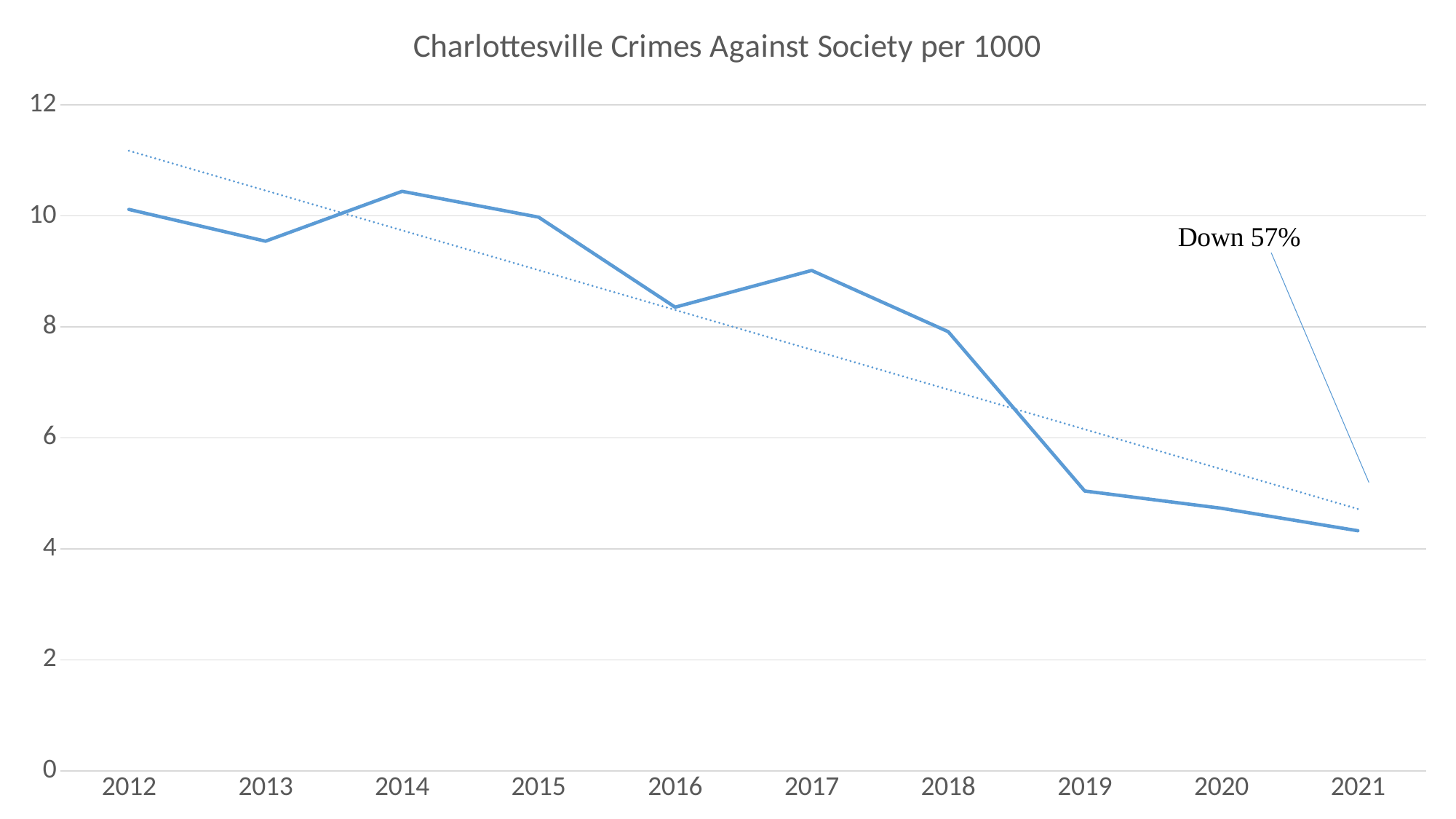
How many years are plotted along the x axis? 10 Is the value for 2019 greater or less than 6? less What does the annotation on the chart say about the change? Down 57% Is the value for 2021 greater or less than 4? greater Is the value for 2013 greater or less than 10? less Which is larger, the value for 2018 or the value for 2019? 2018 Which year has the lowest value? 2021 Overall, do the values rise or fall from 2012 to 2021? fall What is the title of the chart? Charlottesville Crimes Against Society per 1000 What kind of chart is shown on the slide? line chart Which year has the highest value? 2014